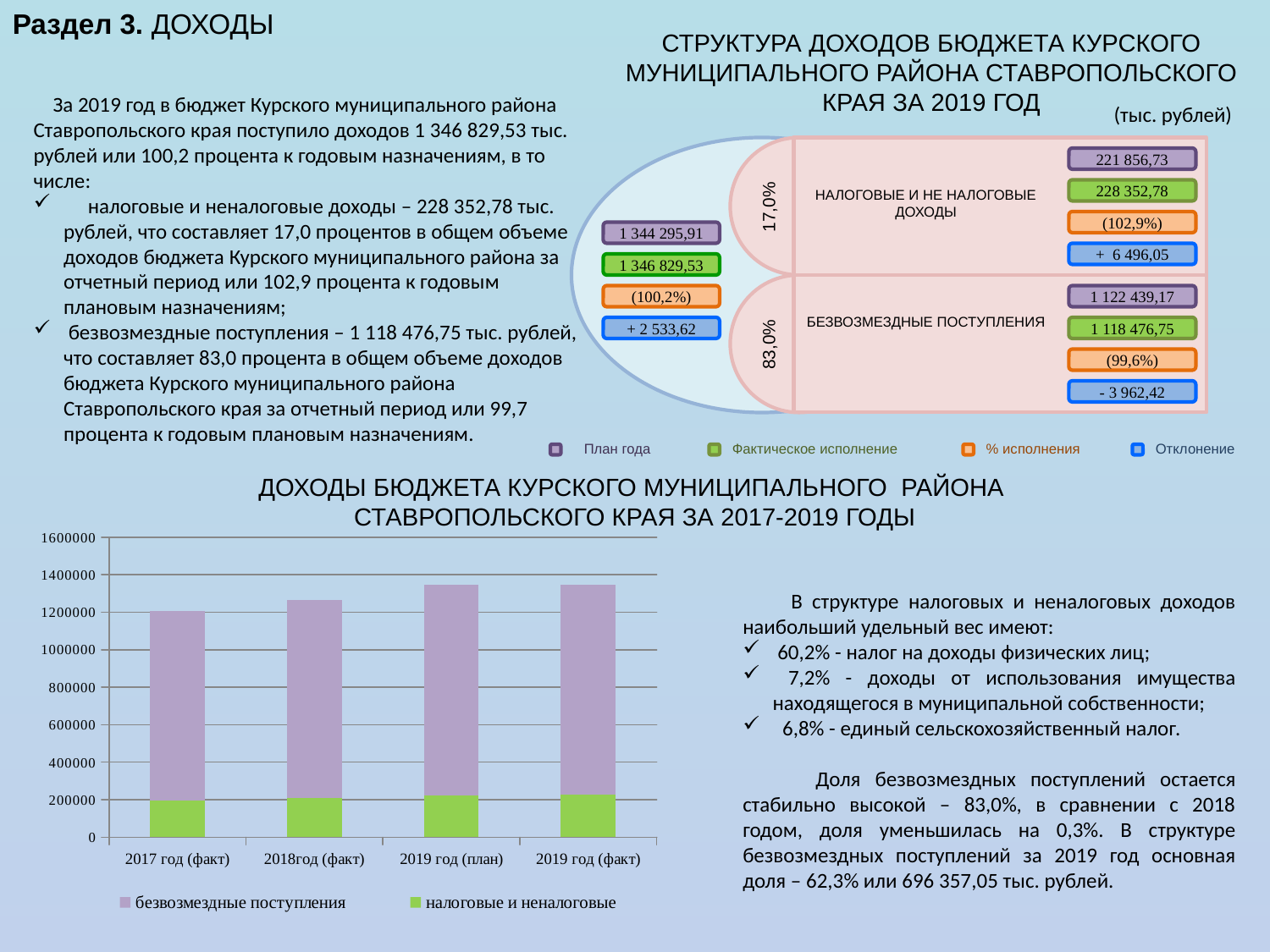
In the bar chart, which total is larger: 2018год (факт) or 2017 год (факт)? 2018год (факт) In the bar chart, do the total bar heights rise or fall from 2017 год (факт) to 2019 год (факт)? rise Which two series are listed in the legend of the bar chart? безвозмездные поступления; налоговые и неналоговые How many series does the legend of the bar chart list? 2 In the bar chart, is the total for 2017 год (факт) greater or less than 1000000? greater In the bar chart, which category has the lowest total bar height? 2017 год (факт) What kind of chart is shown at the bottom left of the slide? stacked bar chart In the bar chart, is the value of налоговые и неналоговые for 2017 год (факт) greater or less than 400000? less In the bar chart, which series occupies the larger part of each stacked bar? безвозмездные поступления How many categories (years) are shown on the x axis of the bar chart? 4 In the bar chart, is the total for 2019 год (факт) greater or less than 1400000? less What is the maximum value shown on the y axis of the bar chart? 1600000